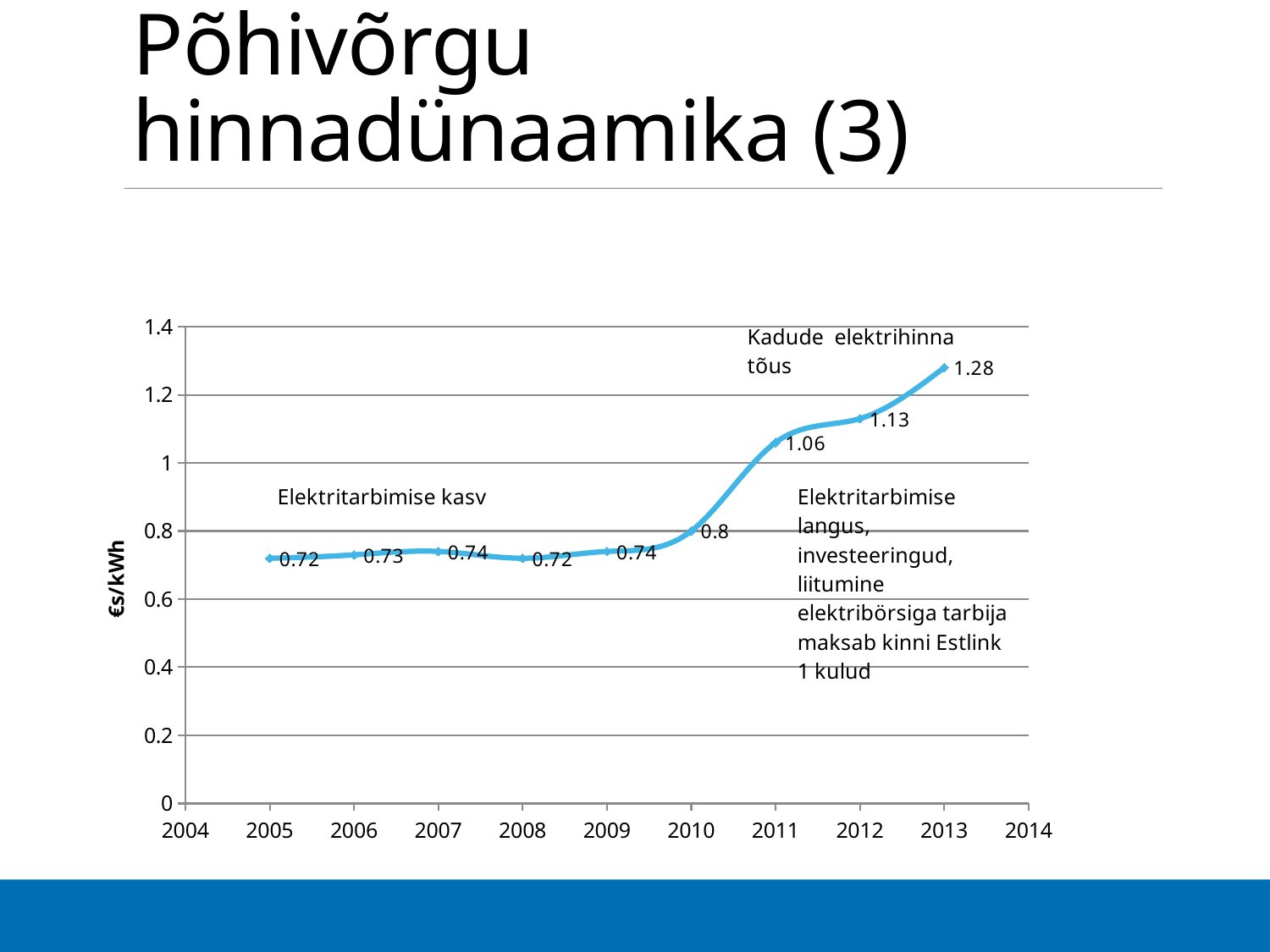
What is the value for 2011? 1.06 Which year has the highest value? 2013 What is the label on the vertical axis? €s/kWh What is the value for 2010? 0.8 Do the values generally rise or fall from 2009 to 2013? rise Which is larger, the value for 2012 or the value for 2009? 2012 How many data points are plotted on the line? 9 What is the value for 2013? 1.28 What type of chart is shown on the slide? line chart What is the difference between the values for 2013 and 2012? 0.15 What is the difference between the values for 2011 and 2010? 0.26 What is the value for 2005? 0.72